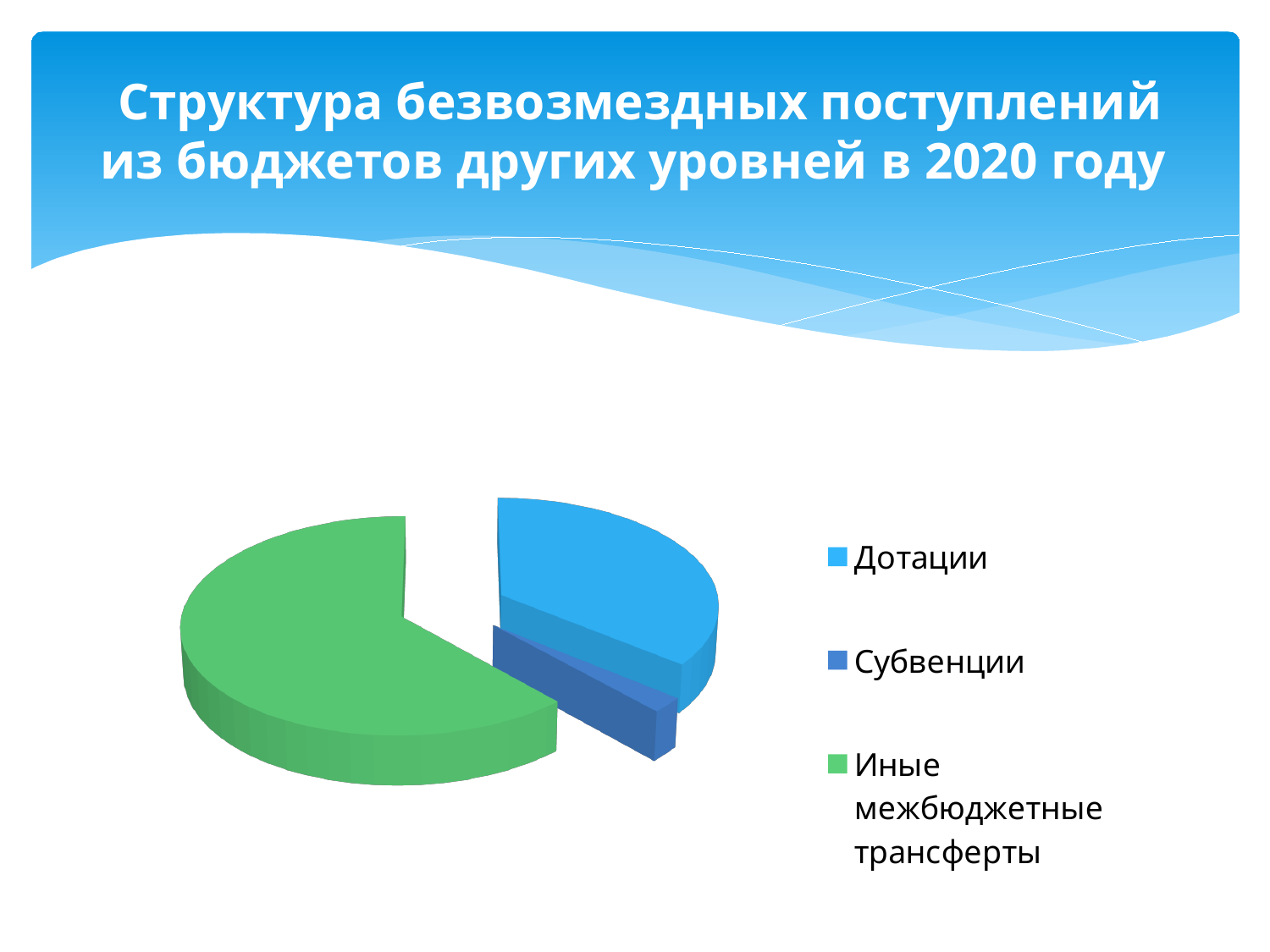
How many entries does the legend list? 3 Is the share of Иные межбюджетные трансферты greater or less than half of the pie? greater Which slice is larger, Дотации or Субвенции? Дотации Which slice is larger, Иные межбюджетные трансферты or Дотации? Иные межбюджетные трансферты What is the title of the slide? Структура безвозмездных поступлений из бюджетов других уровней в 2020 году What kind of chart is shown on the slide? pie chart Which category has the largest slice of the pie? Иные межбюджетные трансферты Which category has the smallest slice of the pie? Субвенции What colour is the slice for Иные межбюджетные трансферты? green How many slices does the pie chart have? 3 Which year does the chart refer to? 2020